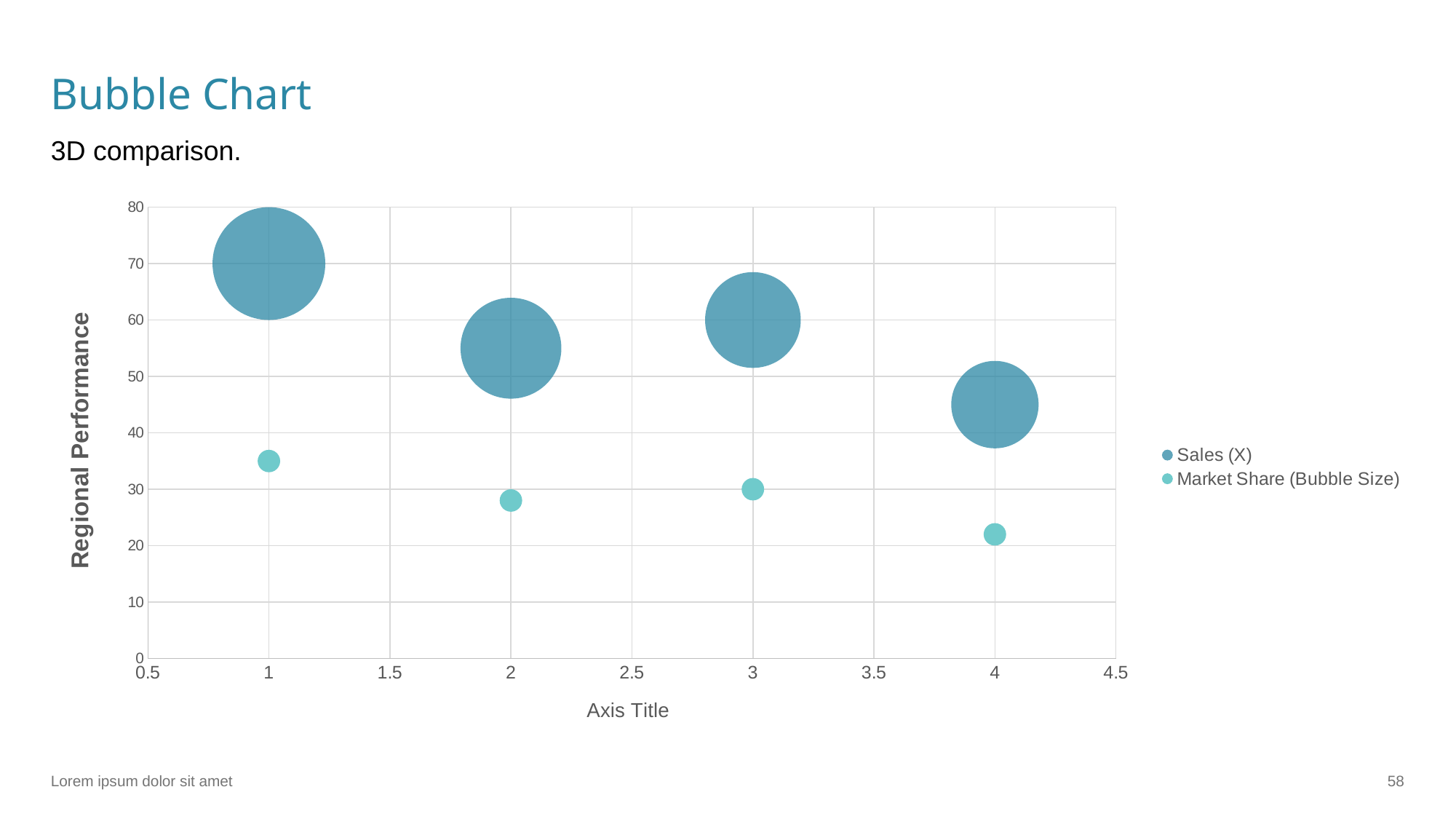
At which x position is the Sales (X) bubble lowest on the vertical axis? 4 Is the Market Share (Bubble Size) value at x = 4 greater or less than 30? less Which Market Share (Bubble Size) point is higher on the vertical axis, the one at x = 1 or the one at x = 4? x = 1 Is the Sales (X) value at x = 4 greater or less than 50? less How many bubbles are plotted for the Sales (X) series? 4 Which Sales (X) bubble is higher on the vertical axis, the one at x = 2 or the one at x = 3? x = 3 What are the two series named in the legend? Sales (X) and Market Share (Bubble Size) What is the title of the vertical axis? Regional Performance What kind of chart is shown on the slide? bubble chart How many series does the legend list? 2 At which x position is the Sales (X) bubble highest on the vertical axis? 1 Is the Sales (X) value at x = 1 greater or less than 60? greater